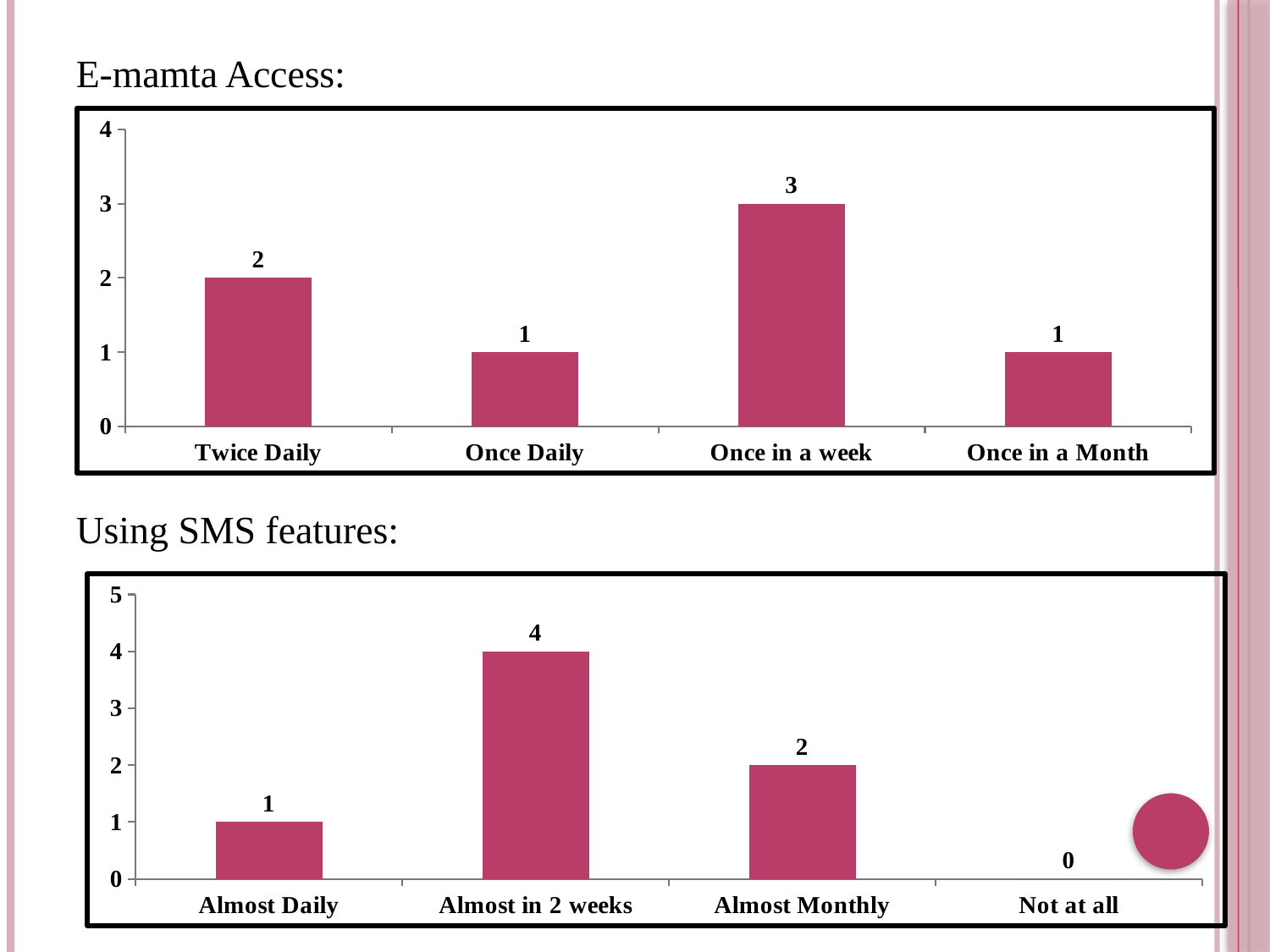
In the Using SMS features chart, what is the value for Not at all? 0 In the E-mamta Access chart, what is the value for Once Daily? 1 In the E-mamta Access chart, what is the value for Once in a week? 3 What kind of chart is the Using SMS features chart? Bar chart In the Using SMS features chart, what is the value for Almost in 2 weeks? 4 In the E-mamta Access chart, what is the difference between Once in a week and Twice Daily? 1 In the E-mamta Access chart, which category has the highest value? Once in a week In the Using SMS features chart, which category has the lowest value? Not at all In the Using SMS features chart, which is larger, Almost Daily or Almost Monthly? Almost Monthly In the Using SMS features chart, what is the difference between Almost in 2 weeks and Almost Monthly? 2 In the E-mamta Access chart, which is larger, Twice Daily or Once in a Month? Twice Daily In the E-mamta Access chart, how many categories are shown on the x axis? 4